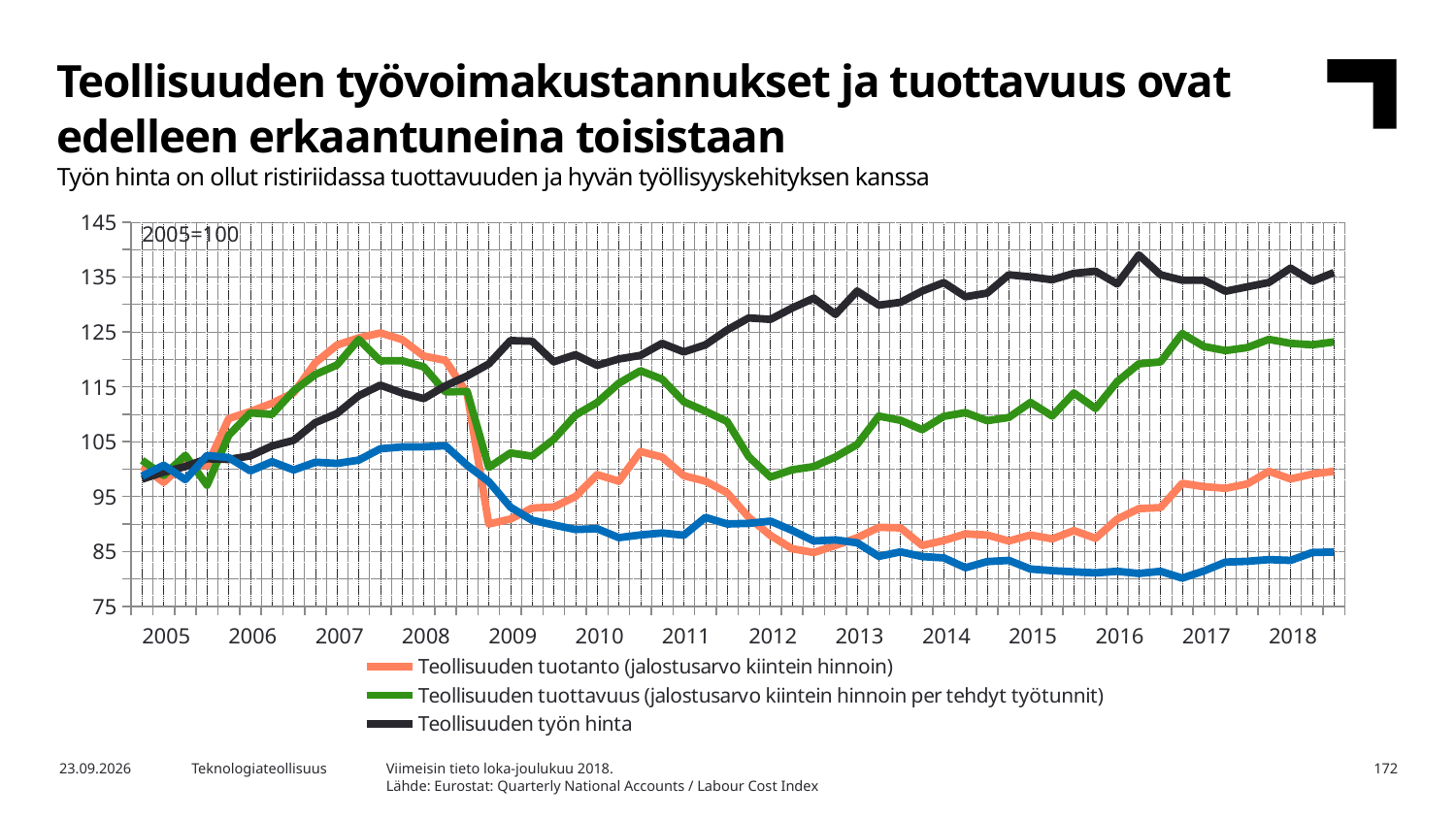
How many year labels are shown on the x axis? 14 What index base is stated in the chart (the note in the top-left corner of the plot area)? 2005=100 How many series does the legend list? 3 What kind of chart is shown on the slide? line chart Is the value of Teollisuuden työn hinta at the end of 2018 greater or less than 125? greater Is the value of Teollisuuden tuotanto at the end of 2018 greater or less than 105? less Is the value of Teollisuuden tuotanto at the start of 2009 greater or less than 95? less Which series does the black line represent? Teollisuuden työn hinta Does the Teollisuuden työn hinta line rise or fall overall from 2005 to 2018? rise Which of the series listed in the legend has the highest value at the end of 2018? Teollisuuden työn hinta At the end of 2018, which is higher: Teollisuuden työn hinta or Teollisuuden tuotanto? Teollisuuden työn hinta